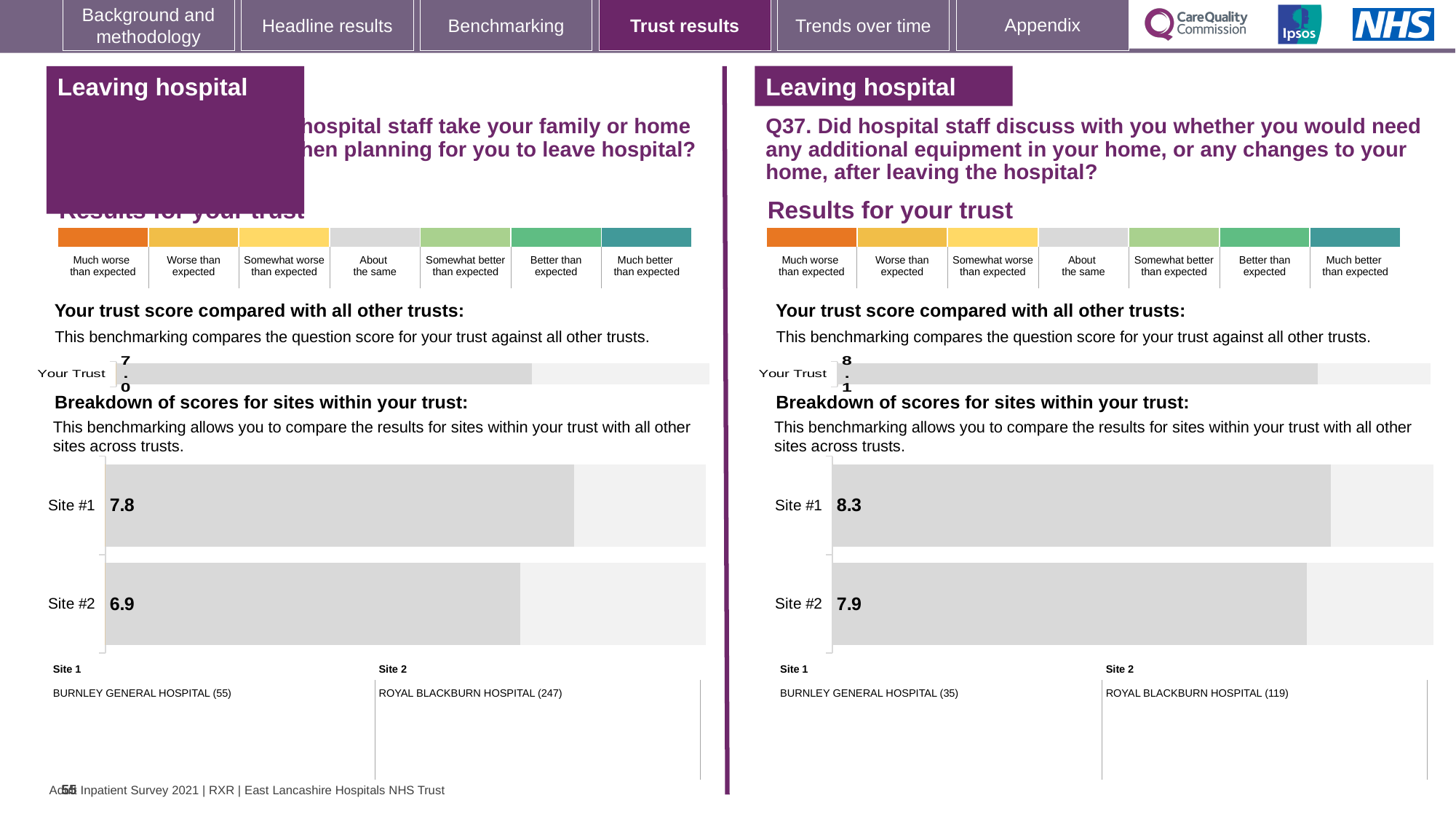
On the left-hand site breakdown chart, what is the score for Site #2? 6.9 On the right-hand (Q37) site breakdown chart, what is the score for Site #2? 7.9 On the left-hand site breakdown chart, which site has the higher score? Site #1 On the right-hand (Q37) site breakdown chart, what is the score for Site #1? 8.3 What kind of chart is the left-hand site breakdown chart? Bar chart On the right-hand (Q37) site breakdown chart, which site has the lower score? Site #2 On the left-hand site breakdown chart, what is the score for Site #1? 7.8 On the right-hand (Q37) 'Your Trust' chart, what is the trust score shown? 8.1 On the right-hand (Q37) site breakdown chart, what is the difference between the Site #1 and Site #2 scores? 0.4 On the left-hand 'Your Trust' chart, what is the trust score shown? 7.0 How many sites are shown on the right-hand (Q37) site breakdown chart? 2 On the left-hand site breakdown chart, what is the difference between the Site #1 and Site #2 scores? 0.9